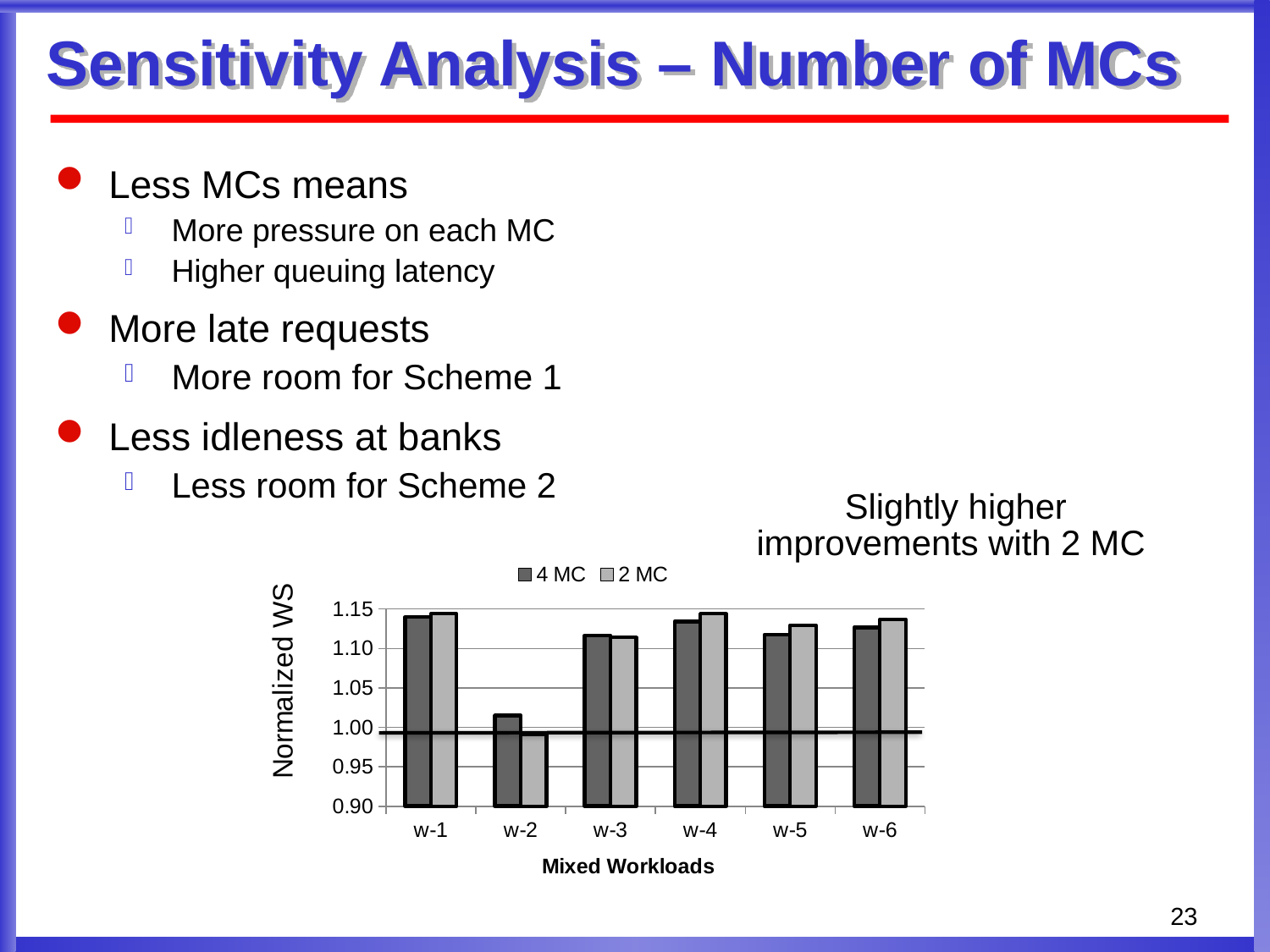
What is the label of the x axis of the chart? Mixed Workloads What kind of chart is shown on the slide? bar chart Is the 4 MC value for w-1 greater or less than 1.10? greater For w-2, which series has the larger Normalized WS, 4 MC or 2 MC? 4 MC What is the label of the y axis of the chart? Normalized WS Is the 2 MC value for w-2 greater or less than 1.00? less How many series does the chart's legend list? 2 Which workload has the lowest Normalized WS for the 2 MC series? w-2 Which workload has the lowest Normalized WS for the 4 MC series? w-2 For the 4 MC series, which workload has the larger Normalized WS, w-1 or w-2? w-1 Is the 2 MC value for w-5 greater or less than 1.05? greater How many workload categories are shown on the x axis of the chart? 6